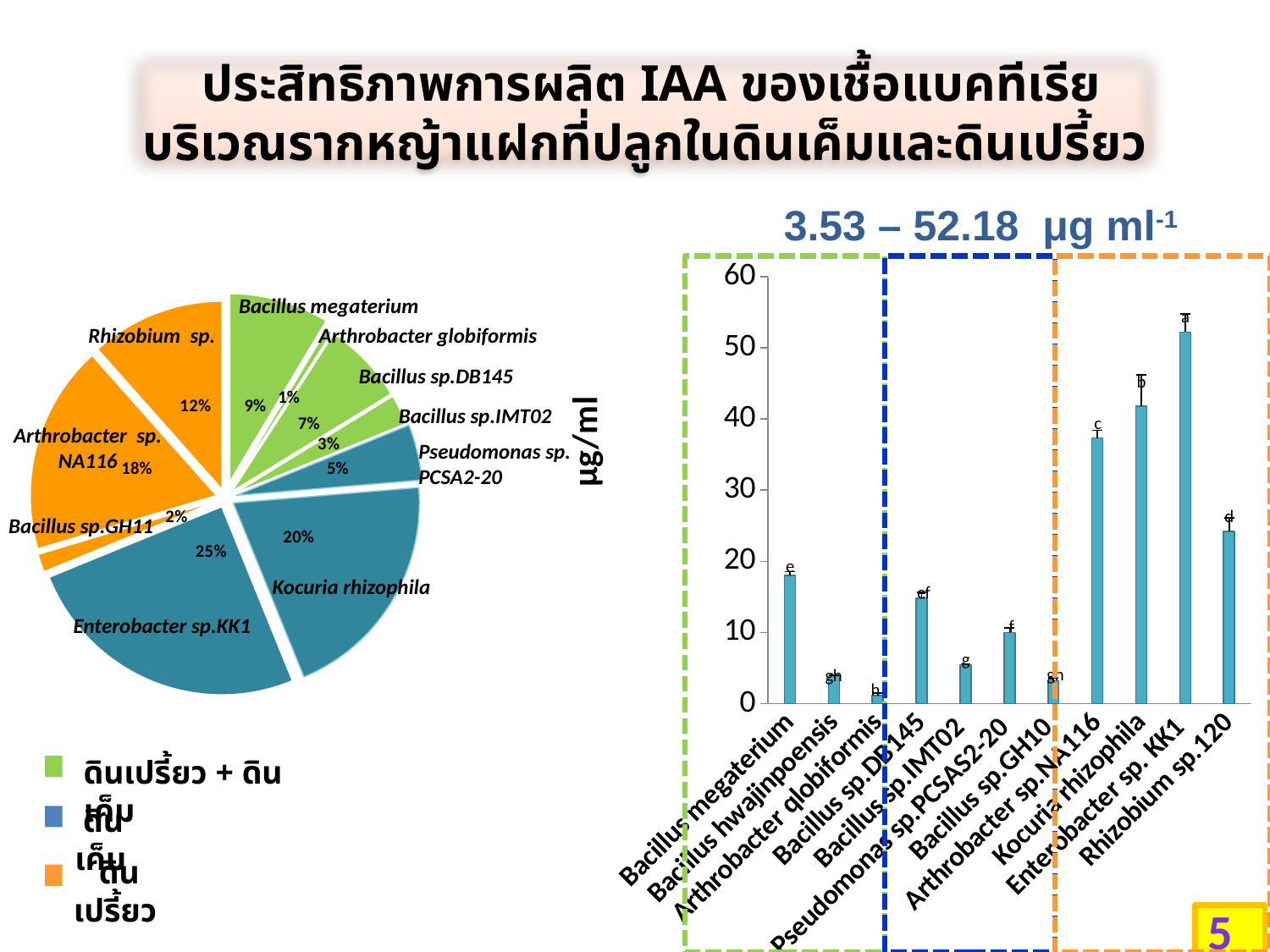
What kind of chart is the chart on the right of the slide? Bar chart In the bar chart on the right, which bacterium has the highest IAA value? Enterobacter sp. KK1 In the pie chart on the left, what percentage is shown for Arthrobacter sp. NA116? 18% In the pie chart on the left, how many slices are there? 10 What kind of chart is the chart on the left of the slide? Pie chart In the pie chart on the left, which slice has the largest share? Enterobacter sp.KK1 In the pie chart on the left, how many percentage points larger is the Enterobacter sp.KK1 slice than the Kocuria rhizophila slice? 5 In the bar chart on the right, is the value for Enterobacter sp. KK1 greater or less than 50? greater In the bar chart on the right, which is larger, the value for Kocuria rhizophila or the value for Arthrobacter sp.NA116? Kocuria rhizophila In the pie chart on the left, what percentage is shown for Enterobacter sp.KK1? 25% In the pie chart on the left, which slice has the smallest share? Arthrobacter globiformis In the bar chart on the right, is the value for Bacillus megaterium greater or less than 20? less